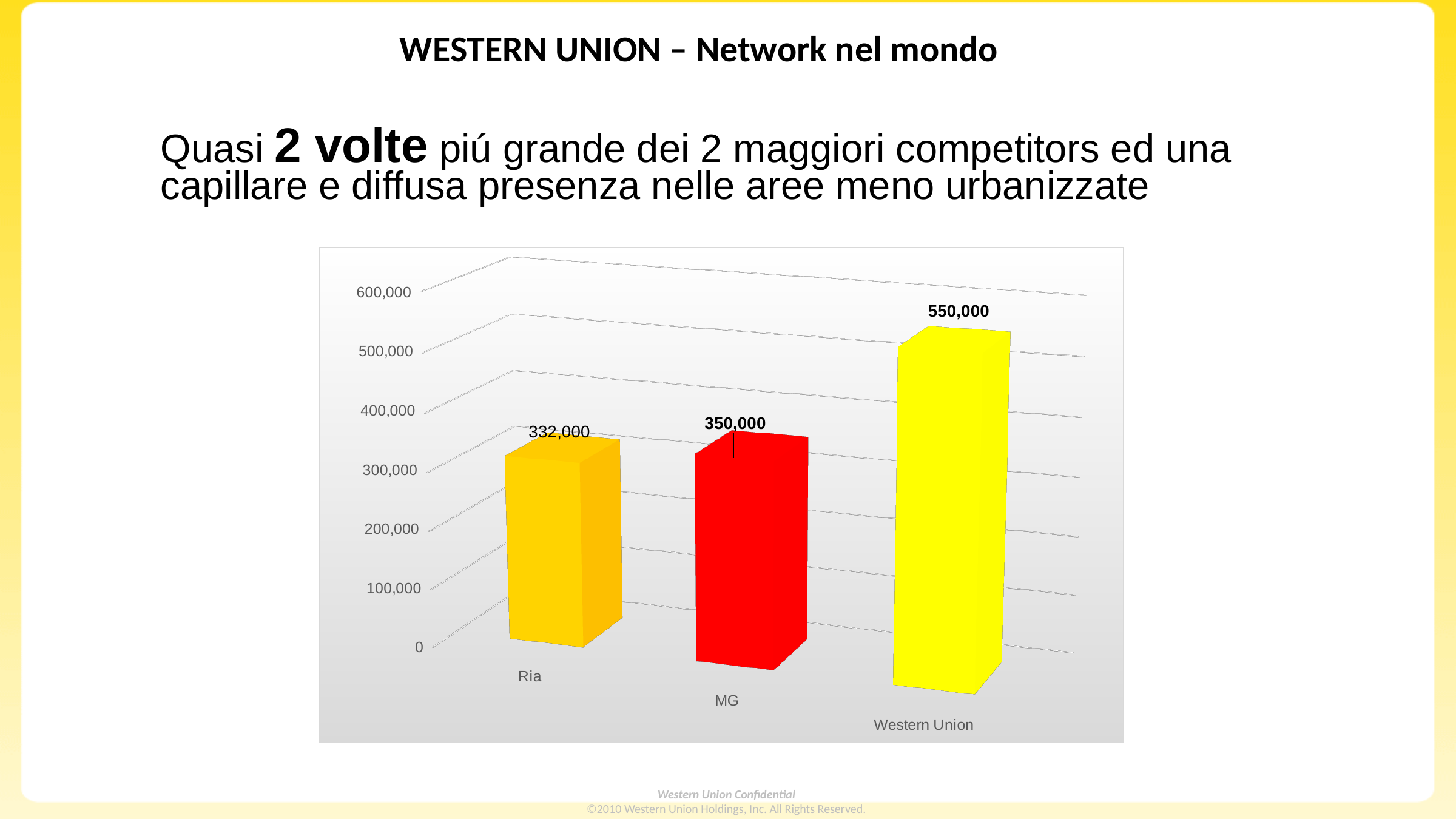
What colour is the bar for MG? red What is the value shown for MG? 350,000 Which category has the highest value? Western Union Is the value for Western Union greater or less than 500,000? greater Which is larger, the value for Western Union or the value for Ria? Western Union What is the difference between the values for MG and Ria? 18,000 Which category has the lowest value? Ria What is the value shown for Ria? 332,000 What is the difference between the values for Western Union and MG? 200,000 What is the value shown for Western Union? 550,000 What kind of chart is shown on the slide? bar chart How many categories are shown in the chart? 3